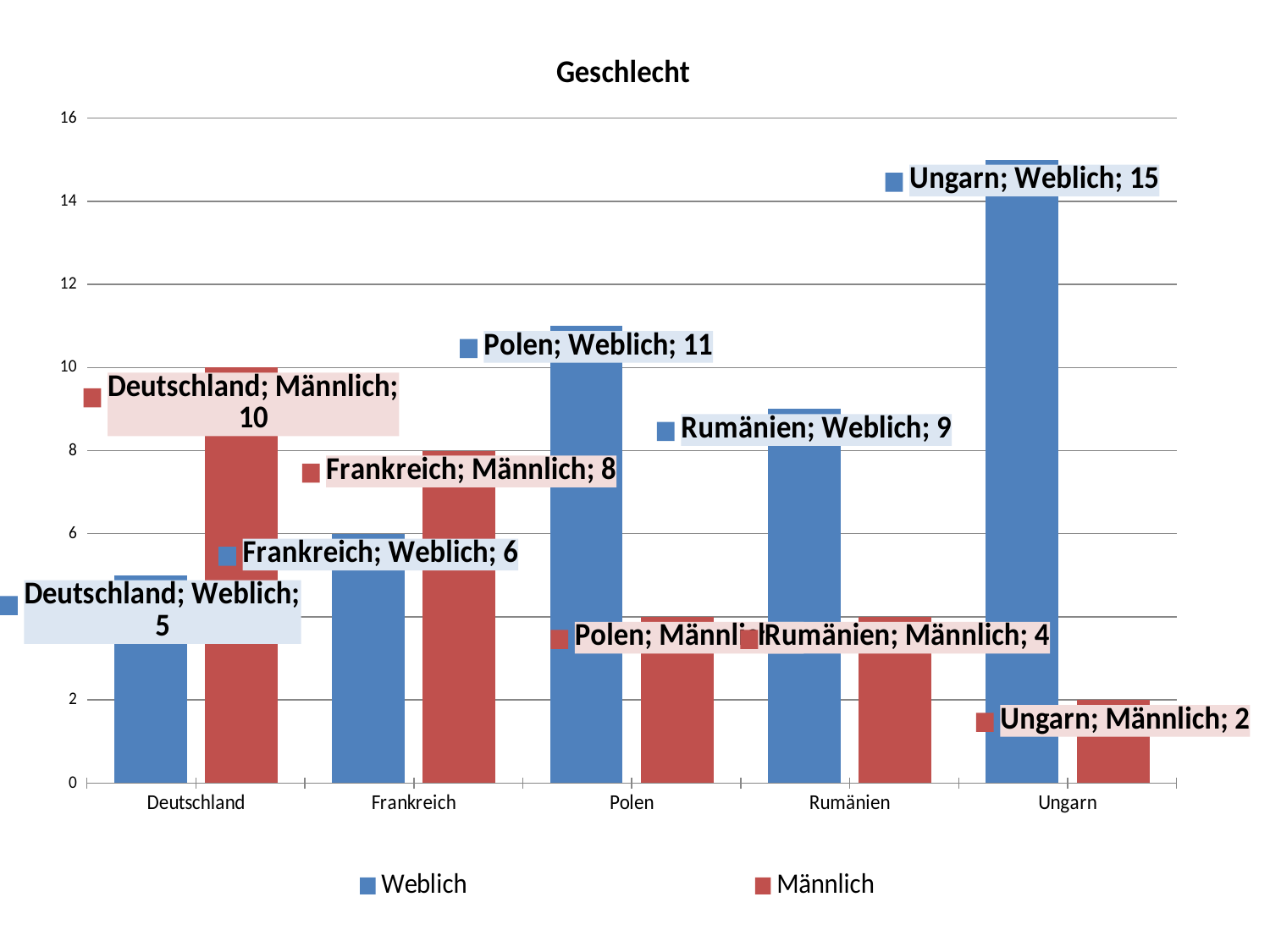
How many series does the legend list? 2 How many countries are shown on the x axis? 5 Which country has the highest Weblich value? Ungarn Which country has the lowest Männlich value? Ungarn What is the value for Weblich in Rumänien? 9 Is the Männlich value for Polen greater or less than 6? less What is the difference between the Weblich and Männlich values for Ungarn? 13 What is the value for Männlich in Deutschland? 10 What is the title of the chart? Geschlecht For Deutschland, which is larger: Weblich or Männlich? Männlich What is the value for Weblich in Ungarn? 15 What kind of chart is shown on the slide? bar chart